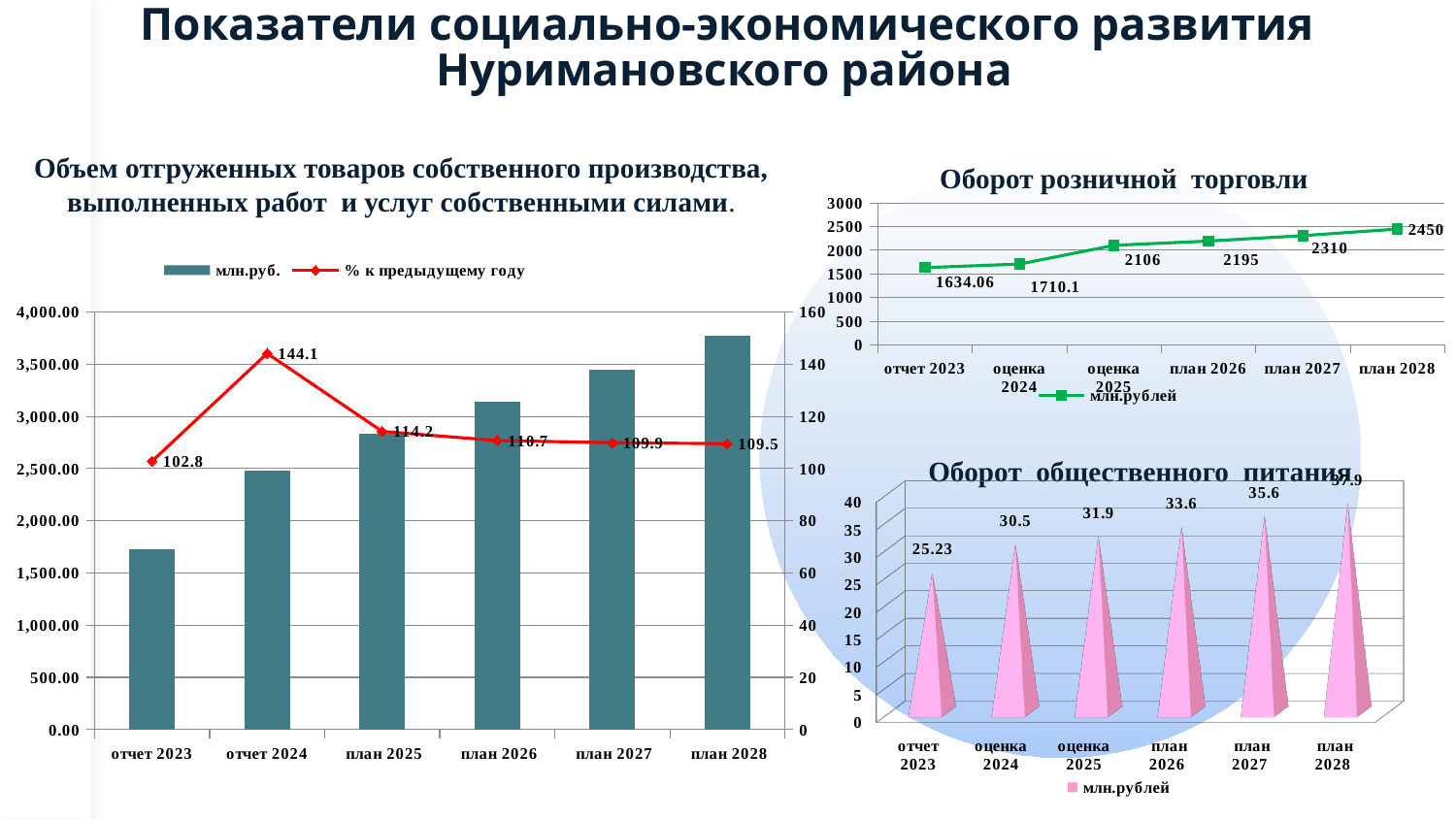
On the chart 'Оборот розничной торговли', what is the difference between план 2027 and план 2026? 115 On the left chart 'Объем отгруженных товаров...', what is the value of '% к предыдущему году' for отчет 2024? 144.1 On the chart 'Оборот общественного питания', what is the value for оценка 2025? 31.9 On the chart 'Оборот общественного питания', how many categories are shown on the x axis? 6 On the left chart 'Объем отгруженных товаров...', how many series does the legend list? 2 On the chart 'Оборот общественного питания', what is the difference between план 2028 and план 2027? 2.3 On the chart 'Оборот розничной торговли', what is the value for план 2028? 2450 On the left chart 'Объем отгруженных товаров...', which category has the highest '% к предыдущему году' value? отчет 2024 On the chart 'Оборот общественного питания', which category has the lowest value? отчет 2023 On the chart 'Оборот розничной торговли', do the values rise or fall from отчет 2023 to план 2028? rise On the chart 'Оборот розничной торговли', what is the value for отчет 2023? 1634.06 On the left chart 'Объем отгруженных товаров...', is the bar value (млн.руб.) for план 2028 greater or less than 3,500.00? greater